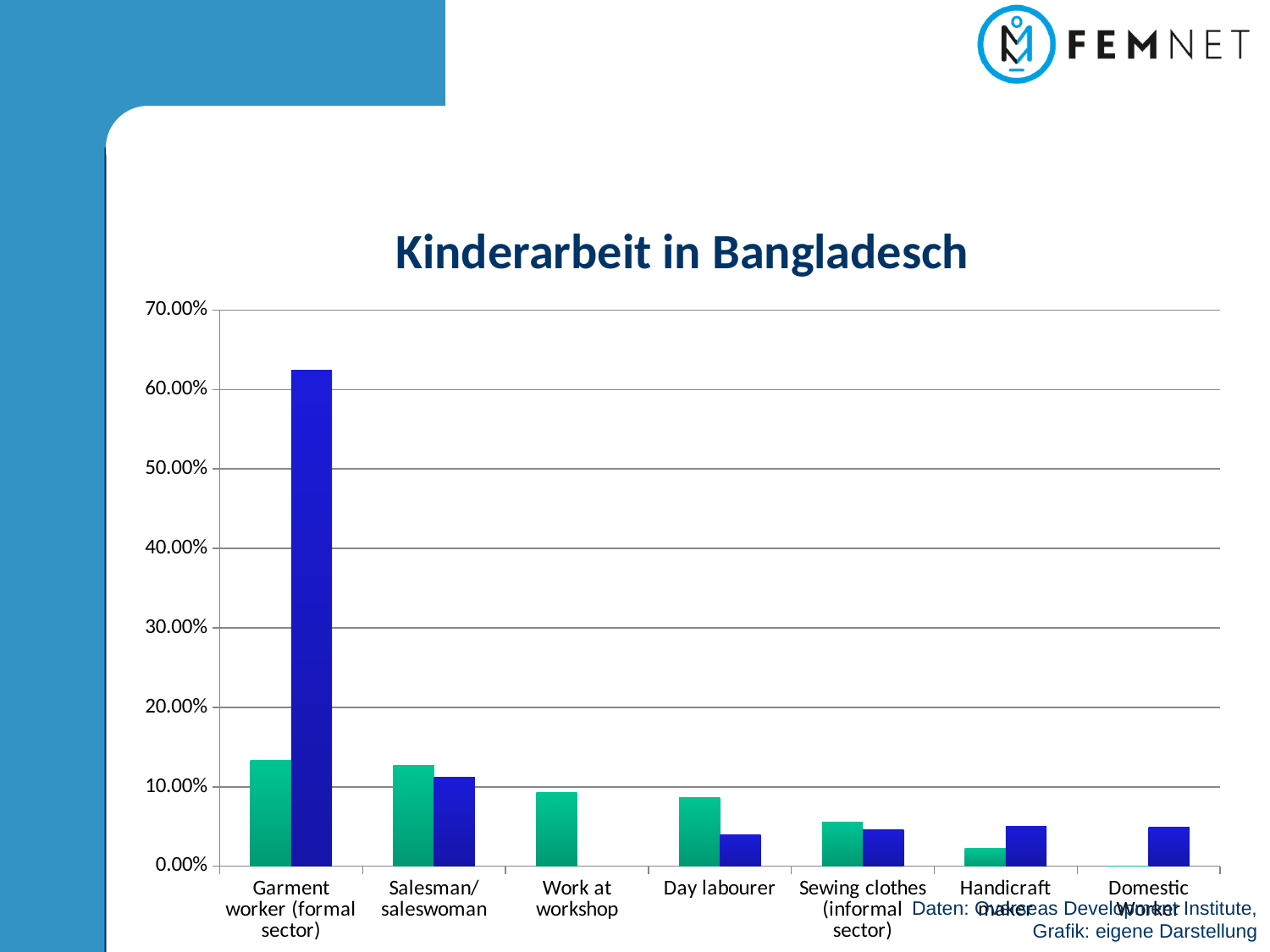
Is the green bar for Garment worker (formal sector) greater or less than 10.00%? greater Is the blue bar for Day labourer greater or less than 10.00%? less Is the blue bar for Domestic worker greater or less than 10.00%? less What is the highest value shown on the y axis of the chart? 70.00% How many categories are shown on the x axis of the chart? 7 What is the title of the chart? Kinderarbeit in Bangladesch Which is larger: the blue bar for Garment worker (formal sector) or the blue bar for Salesman/saleswoman? Garment worker (formal sector) Which is larger: the green bar for Work at workshop or the green bar for Handicraft maker? Work at workshop What kind of chart is shown on the slide? bar chart Which category has the tallest bar in the chart? Garment worker (formal sector)